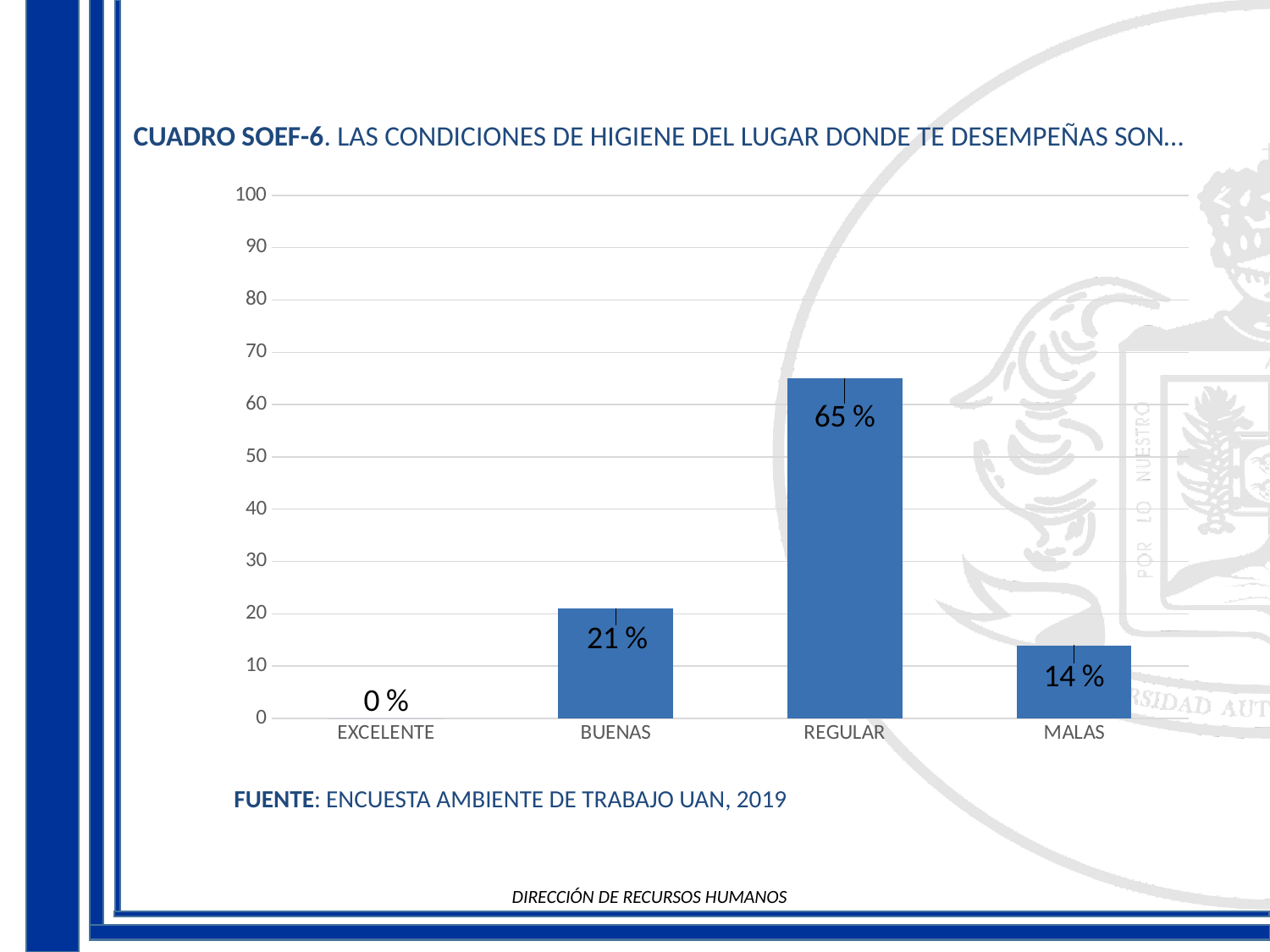
What is the difference between the values for BUENAS and MALAS? 7 % Which category has the highest value? REGULAR What kind of chart is shown on the slide? bar chart Is the value for REGULAR greater or less than 60? greater Which is larger, the value for BUENAS or the value for MALAS? BUENAS What is the difference between the values for REGULAR and BUENAS? 44 % Which category has the lowest value? EXCELENTE What is the value for MALAS? 14 % How many categories are shown on the x axis? 4 What is the value for BUENAS? 21 % What is the value for EXCELENTE? 0 % What is the value for REGULAR? 65 %